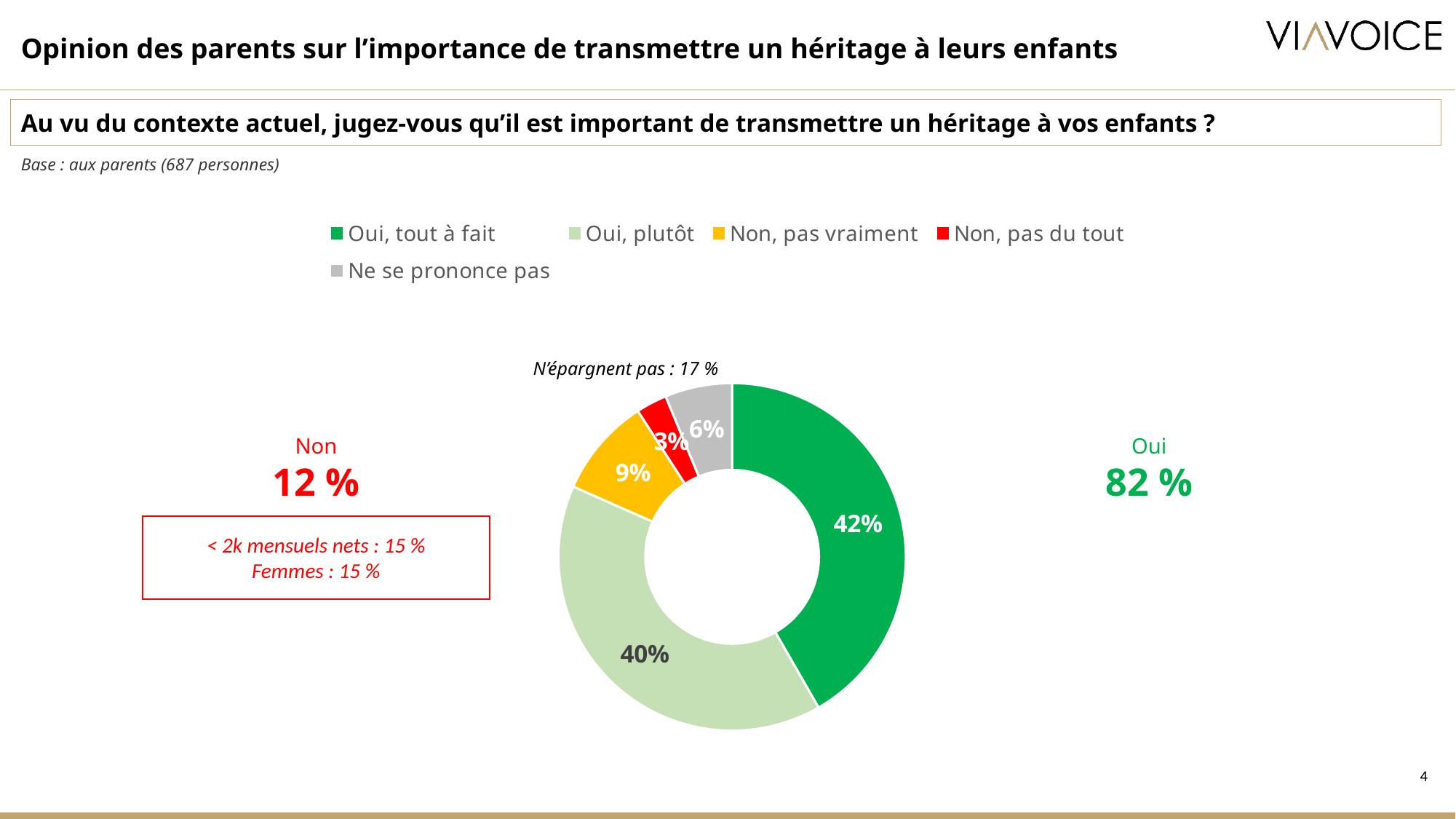
What kind of chart is shown on the slide? Doughnut (pie) chart What percentage of parents answered "Ne se prononce pas"? 6% How many response categories does the legend list? 5 What percentage of parents answered "Non, pas vraiment"? 9% Which is larger: the share for "Non, pas vraiment" or the share for "Ne se prononce pas"? Non, pas vraiment Which response category has the largest share of the chart? Oui, tout à fait What percentage of parents answered "Oui, tout à fait"? 42% What percentage of parents answered "Non, pas du tout"? 3% Which response category has the smallest share of the chart? Non, pas du tout What is the combined "Oui" total shown on the slide? 82 % What percentage of parents answered "Oui, plutôt"? 40% What is the difference in percentage points between "Oui, tout à fait" and "Oui, plutôt"? 2